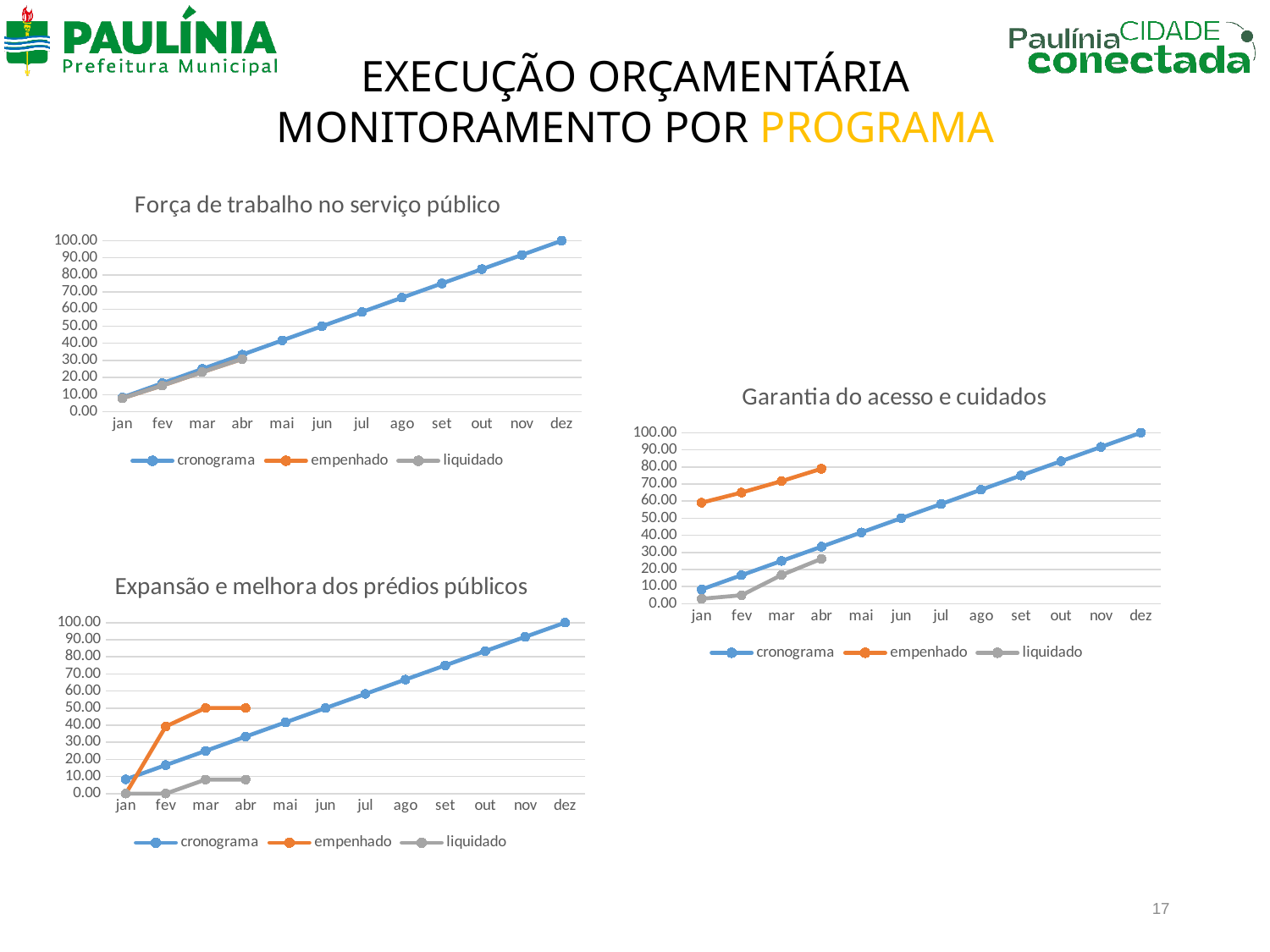
How many series does the legend of "Garantia do acesso e cuidados" list? 3 In "Garantia do acesso e cuidados", is the empenhado value for abr greater or less than 70.00? greater In "Expansão e melhora dos prédios públicos", what is the liquidado value for jan? 0.00 What kind of chart is "Força de trabalho no serviço público"? line chart In "Expansão e melhora dos prédios públicos", which month has the highest cronograma value? dez In "Garantia do acesso e cuidados", what is the cronograma value for jun? 50.00 In "Garantia do acesso e cuidados", which is larger at abr: empenhado or cronograma? empenhado In "Expansão e melhora dos prédios públicos", is the empenhado value for fev greater or less than 30.00? greater In "Força de trabalho no serviço público", what is the cronograma value for dez? 100.00 In "Força de trabalho no serviço público", does the cronograma series rise or fall from jan to dez? rise How many months are shown on the x axis of "Expansão e melhora dos prédios públicos"? 12